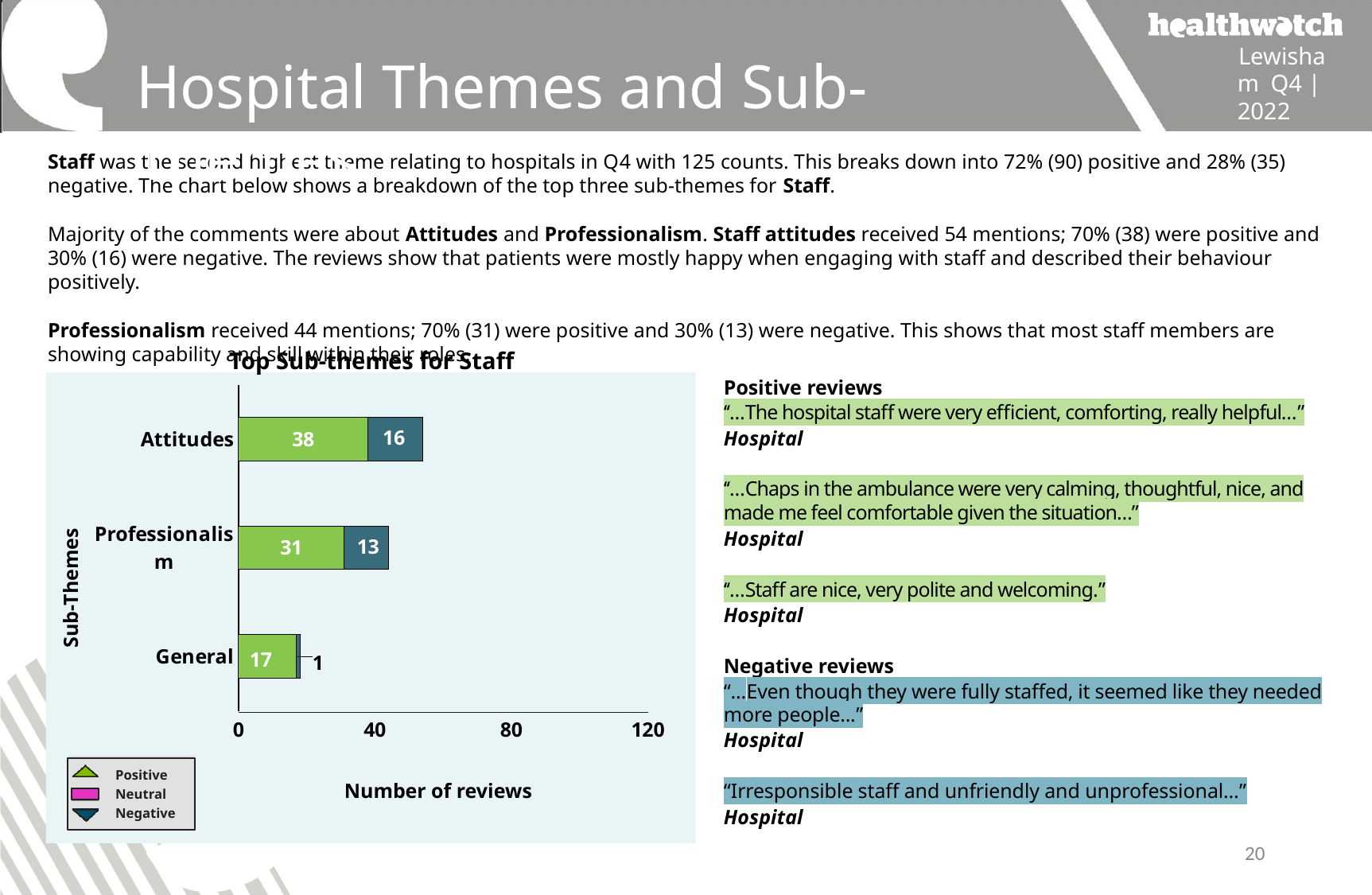
Which sub-theme has the highest Positive value in the Top Sub-themes for Staff chart? Attitudes What is the Positive value for Attitudes in the Top Sub-themes for Staff chart? 38 What type of chart is the Top Sub-themes for Staff chart? Stacked bar chart Which sub-theme has the lowest Negative value in the Top Sub-themes for Staff chart? General How many sub-themes are shown in the Top Sub-themes for Staff chart? 3 What is the Negative value for General in the Top Sub-themes for Staff chart? 1 How many series does the legend of the Top Sub-themes for Staff chart list? 3 What is the total number of reviews for General in the Top Sub-themes for Staff chart? 18 What is the total number of reviews for Attitudes in the Top Sub-themes for Staff chart? 54 What is the difference between the Positive values for Attitudes and Professionalism in the Top Sub-themes for Staff chart? 7 What is the Negative value for Professionalism in the Top Sub-themes for Staff chart? 13 Which is larger in the Top Sub-themes for Staff chart: the Negative value for Attitudes or the Negative value for Professionalism? Attitudes